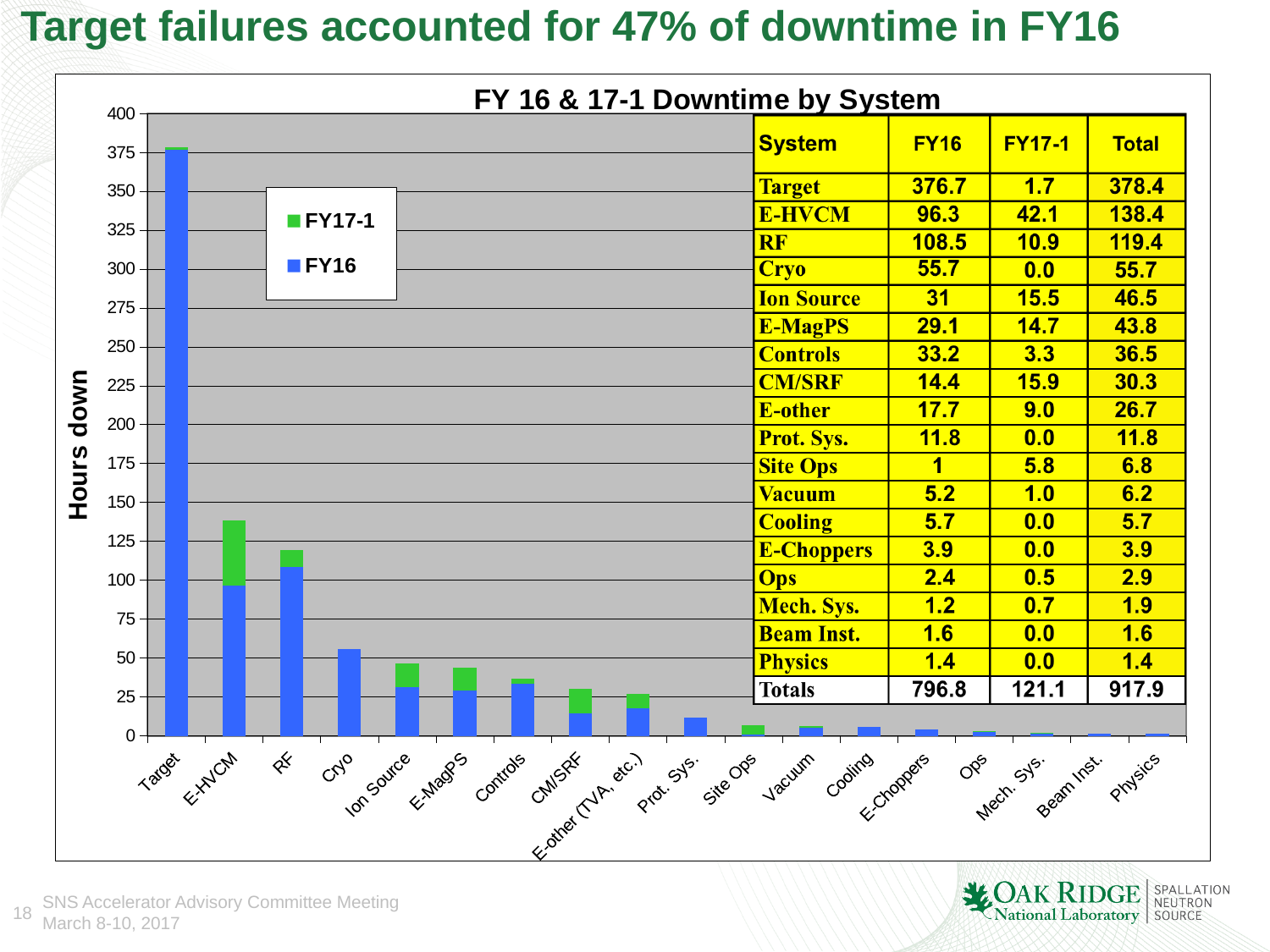
What is the title of the chart? FY 16 & 17-1 Downtime by System What kind of chart is shown on the slide? bar chart How many series does the legend list? 2 What is the FY16 downtime in hours for Target? 376.7 Which system has the highest total downtime? Target What is the FY17-1 downtime in hours for E-HVCM? 42.1 Which has the larger FY16 downtime, Cryo or Controls? Cryo Is the total height of the Target bar greater or less than 350? greater Do the bar heights rise or fall moving from left to right along the x axis? fall How many systems (categories) are plotted along the x axis? 18 What is the total downtime (FY16 plus FY17-1) for the RF stacked bar? 119.4 What is the difference between the FY16 downtime for RF and the FY16 downtime for E-HVCM? 12.2